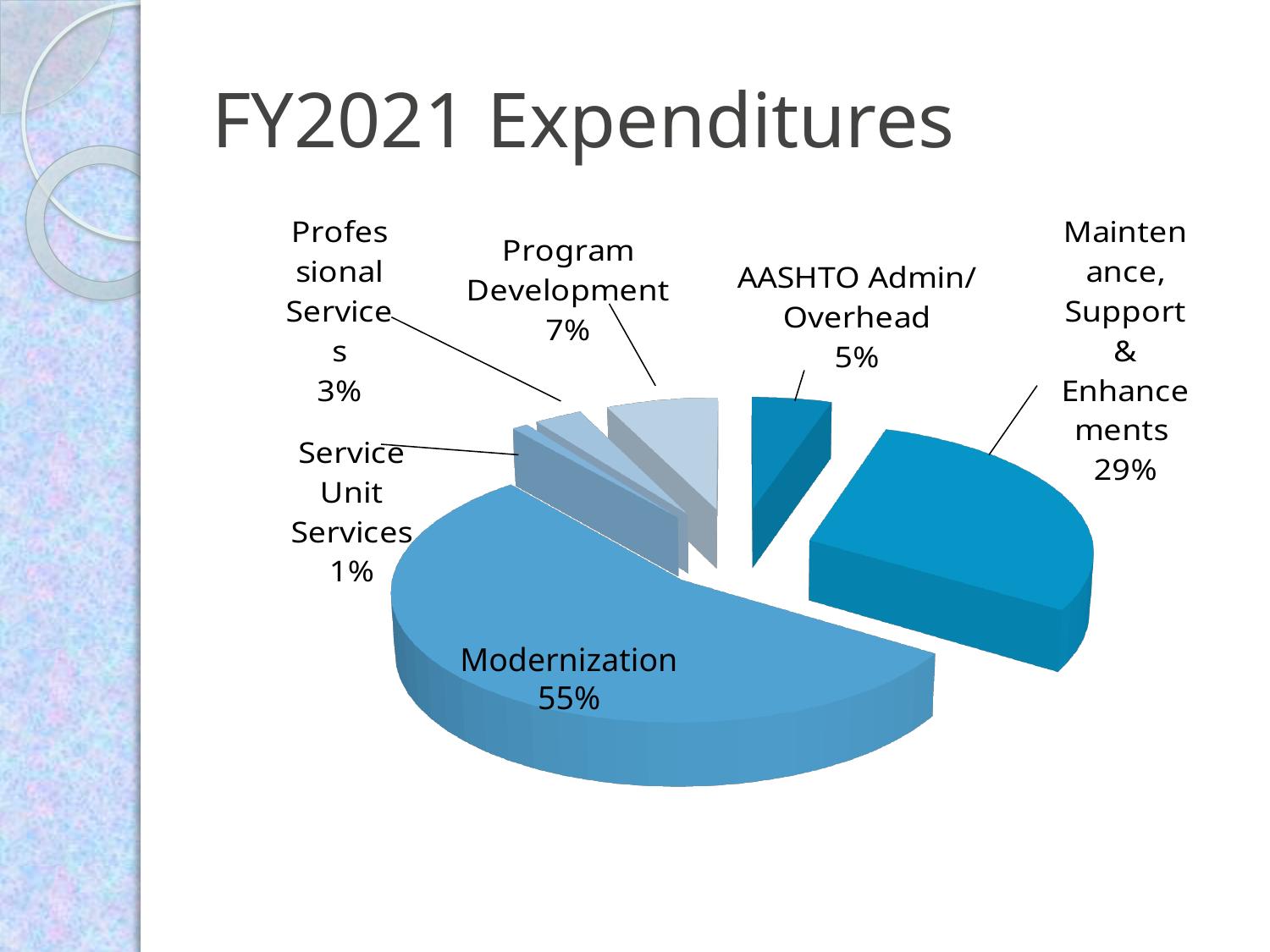
What kind of chart is shown on the slide? Pie chart What is the difference in percentage points between Modernization and Maintenance, Support & Enhancements? 26 What share of FY2021 expenditures is AASHTO Admin/Overhead? 5% How many categories are shown in the pie chart? 6 Which category has the smallest share of FY2021 expenditures? Service Unit Services What share of FY2021 expenditures is Program Development? 7% What share of FY2021 expenditures is Maintenance, Support & Enhancements? 29% Which category has the largest share of FY2021 expenditures? Modernization What share of FY2021 expenditures is Service Unit Services? 1% What is the title of the slide? FY2021 Expenditures What share of FY2021 expenditures is Modernization? 55% Which is larger: Program Development or AASHTO Admin/Overhead? Program Development